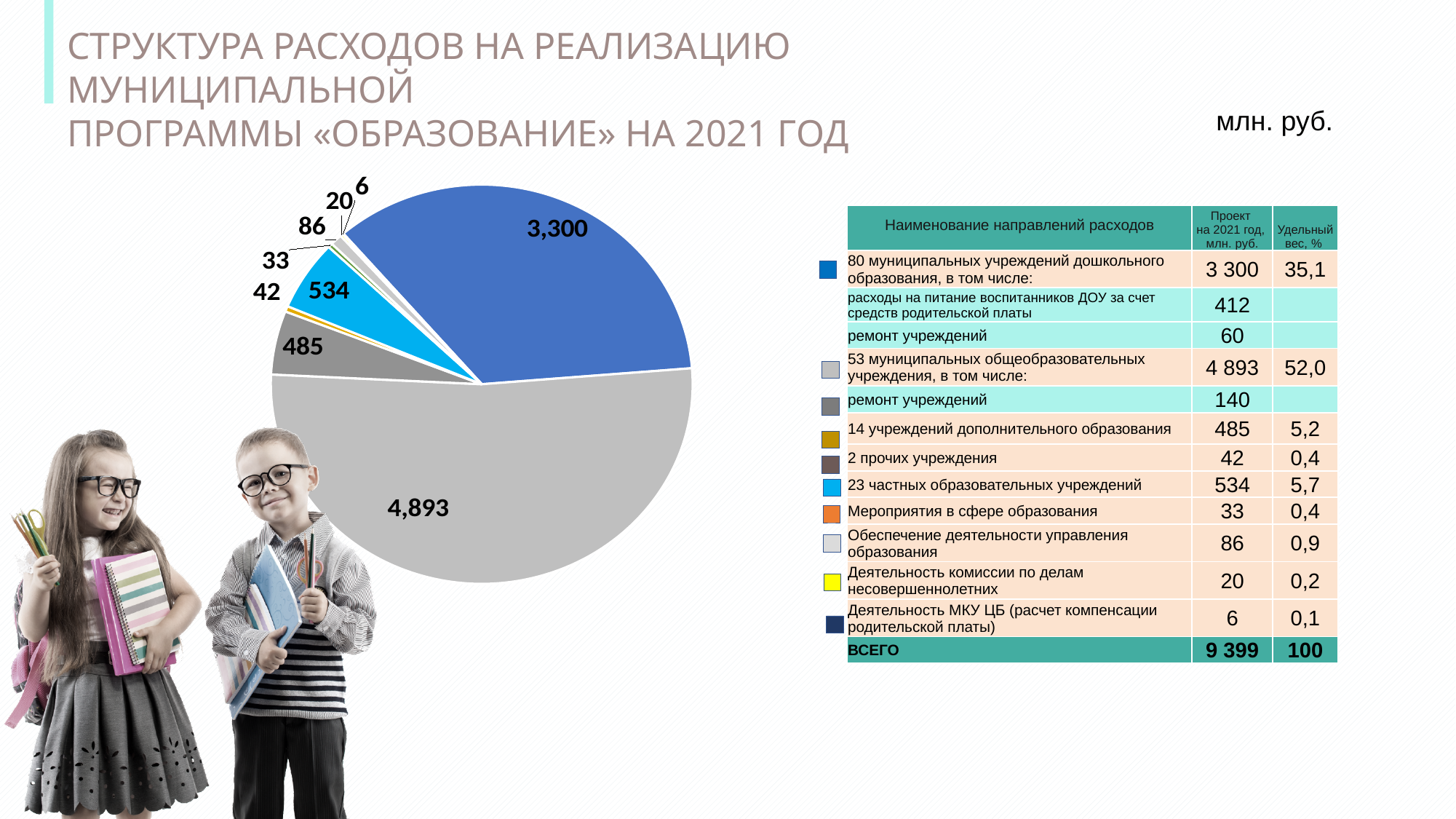
What share of the total do the 80 муниципальных учреждений дошкольного образования account for, according to the table? 35,1 Which expenditure category has the smallest slice of the pie chart? Деятельность МКУ ЦБ (расчет компенсации родительской платы) Which is larger: the slice for 23 частных образовательных учреждений or the slice for 14 учреждений дополнительного образования? 23 частных образовательных учреждений What is the value of the largest slice of the pie chart? 4,893 What is the difference between the two largest slices, 4,893 and 3,300? 1,593 Which expenditure category has the largest slice of the pie chart? 53 муниципальных общеобразовательных учреждения What is the value of the slice for 80 муниципальных учреждений дошкольного образования? 3,300 What kind of chart is shown on the slide? pie chart What is the value of the slice for 23 частных образовательных учреждений? 534 What is the total of all slices in the pie chart (ВСЕГО in the table)? 9 399 In what units are the values on the slide expressed? млн. руб. How many slices does the pie chart have? 9